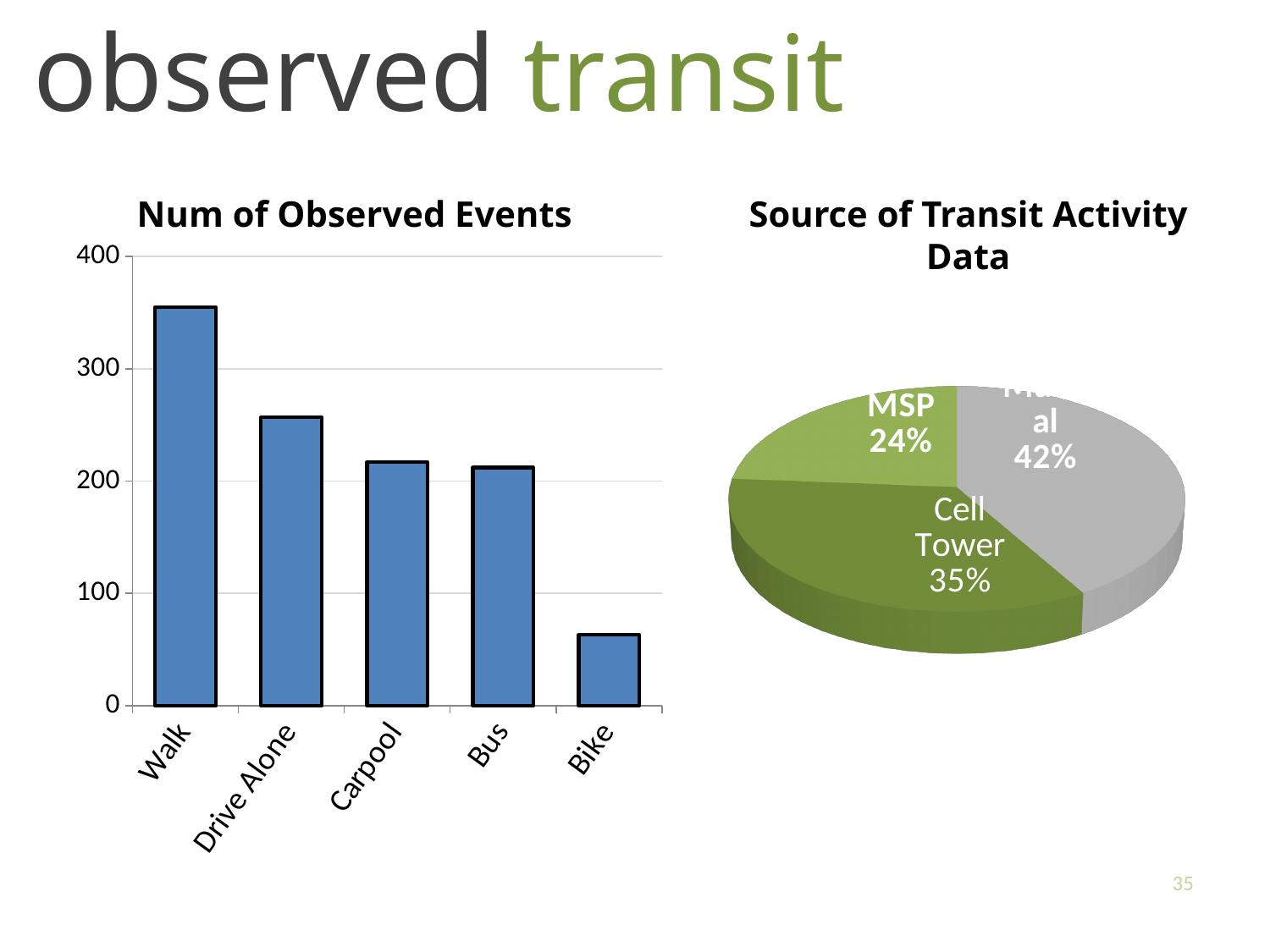
In the Num of Observed Events chart, which category has the lowest value? Bike In the Num of Observed Events chart, what kind of chart is shown? bar chart In the Source of Transit Activity Data chart, how many slices does the pie have? 3 In the Source of Transit Activity Data chart, what is the difference between the Cell Tower share and the MSP share? 11% In the Num of Observed Events chart, how many categories are shown on the x axis? 5 In the Num of Observed Events chart, is the value for Bike greater or less than 100? less In the Num of Observed Events chart, which is larger, the value for Walk or the value for Drive Alone? Walk In the Source of Transit Activity Data chart, what share does MSP have? 24% In the Num of Observed Events chart, is the value for Drive Alone greater or less than 200? greater In the Num of Observed Events chart, is the value for Walk greater or less than 300? greater In the Num of Observed Events chart, which category has the highest value? Walk In the Source of Transit Activity Data chart, what share does Cell Tower have? 35%